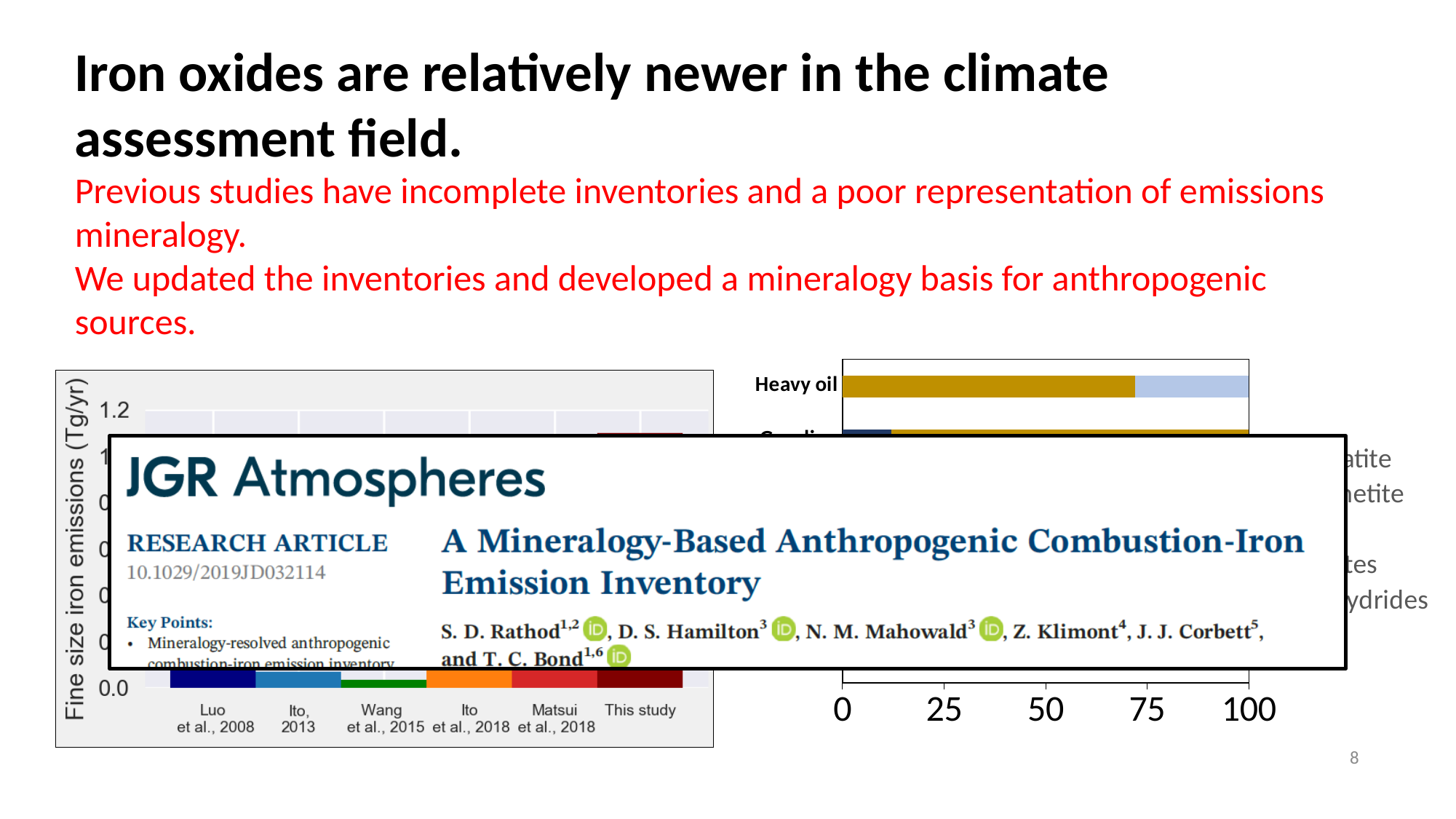
What is the label of the top category in the right chart? Heavy oil What is the label of the last category on the x axis of the left chart? This study How many categories (studies) are shown along the x axis of the left chart? 6 What kind of chart is the chart on the right of the slide? bar chart What kind of chart is the chart on the left of the slide? bar chart What is the highest tick value shown on the x axis of the right chart? 100 What is the highest tick value shown on the y axis of the left chart? 1.2 In the right chart, is the first (gold) segment of the Heavy oil bar greater or less than 50? greater